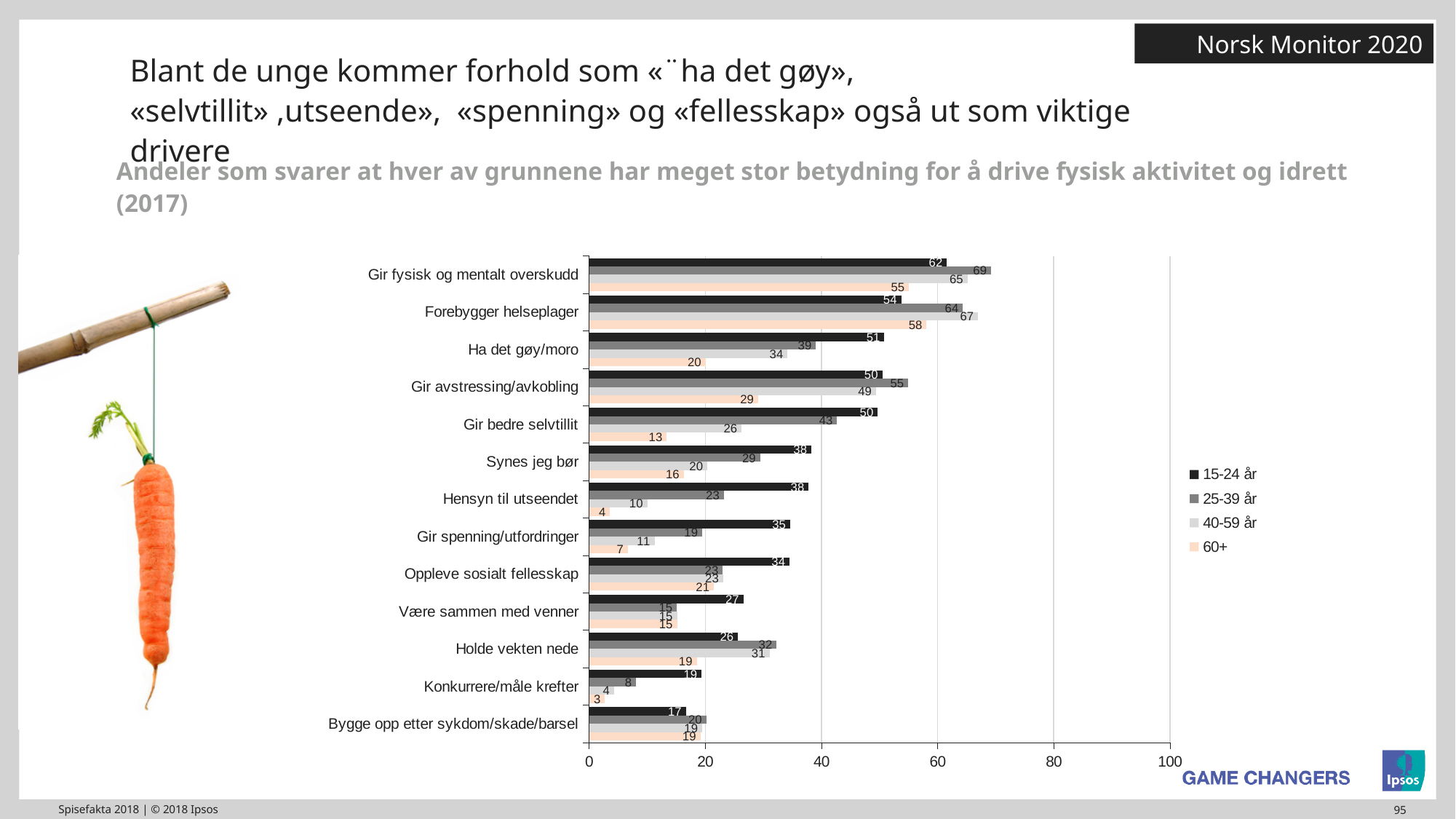
What kind of chart is shown on the slide? Bar chart What is the value for the 25-39 år series for "Gir avstressing/avkobling"? 55 What is the value for the 40-59 år series for "Forebygger helseplager"? 67 Which category has the highest value for the 25-39 år series? Gir fysisk og mentalt overskudd For "Holde vekten nede", which is larger: the 15-24 år value or the 25-39 år value? 25-39 år How many series does the legend list? 4 What is the difference between the 15-24 år and 60+ values for "Gir bedre selvtillit"? 37 What is the value for the 60+ series for "Hensyn til utseendet"? 4 What is the value for the 15-24 år series for "Ha det gøy/moro"? 51 Which series is shown in black on the chart? 15-24 år How many categories are shown on the chart? 13 Which category has the lowest value for the 60+ series? Konkurrere/måle krefter